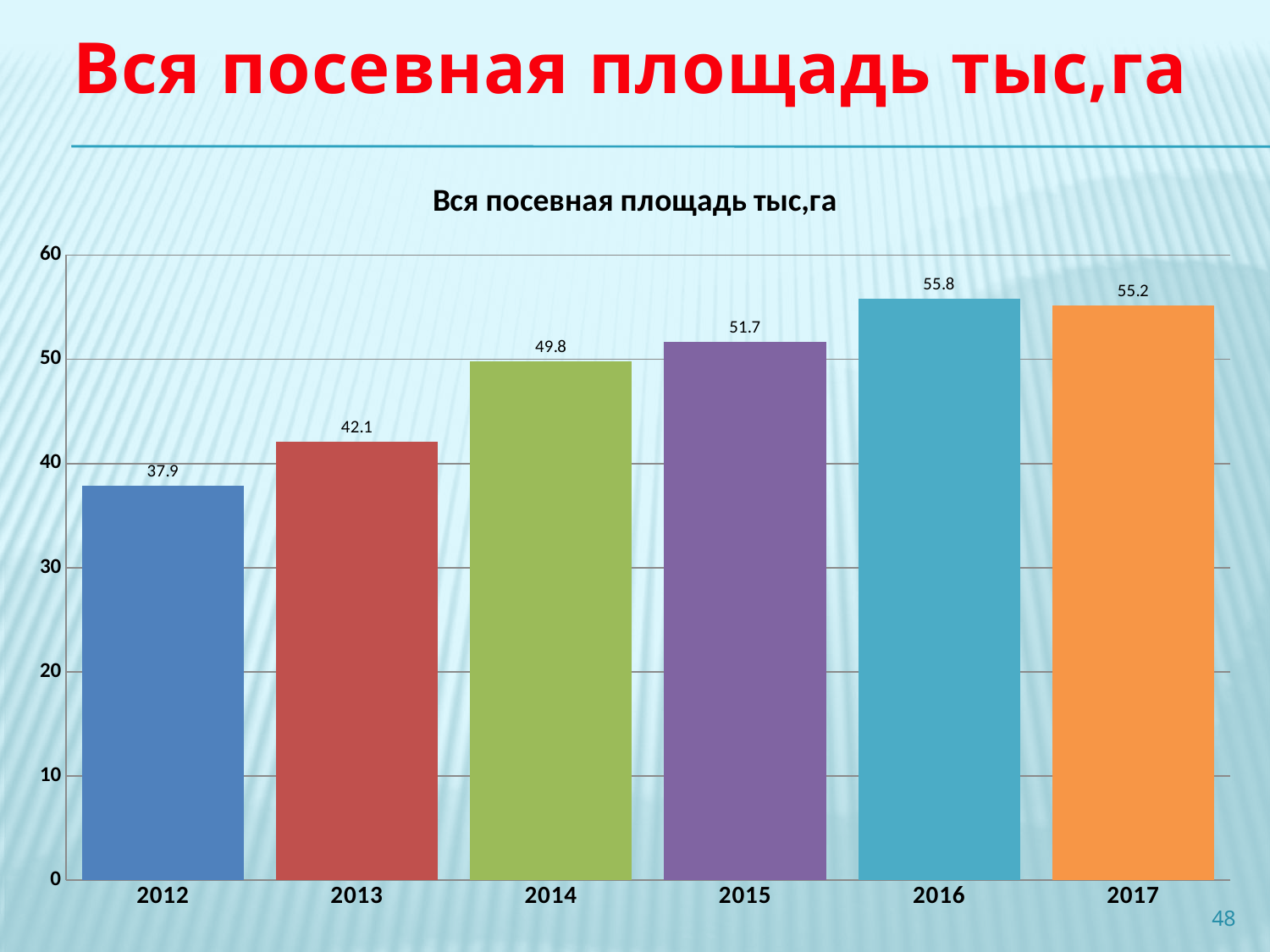
What is the value for 2017? 55.2 How many years are shown on the x axis? 6 What is the title of the chart? Вся посевная площадь тыс,га What is the value for 2015? 51.7 What is the difference between the values for 2014 and 2013? 7.7 What kind of chart is shown on the slide? bar chart What is the difference between the values for 2016 and 2012? 17.9 Which year has the highest value? 2016 What is the value for 2012? 37.9 Is the value for 2015 greater or less than 50? greater Which year has the lowest value? 2012 Which is larger, the value for 2014 or the value for 2013? 2014